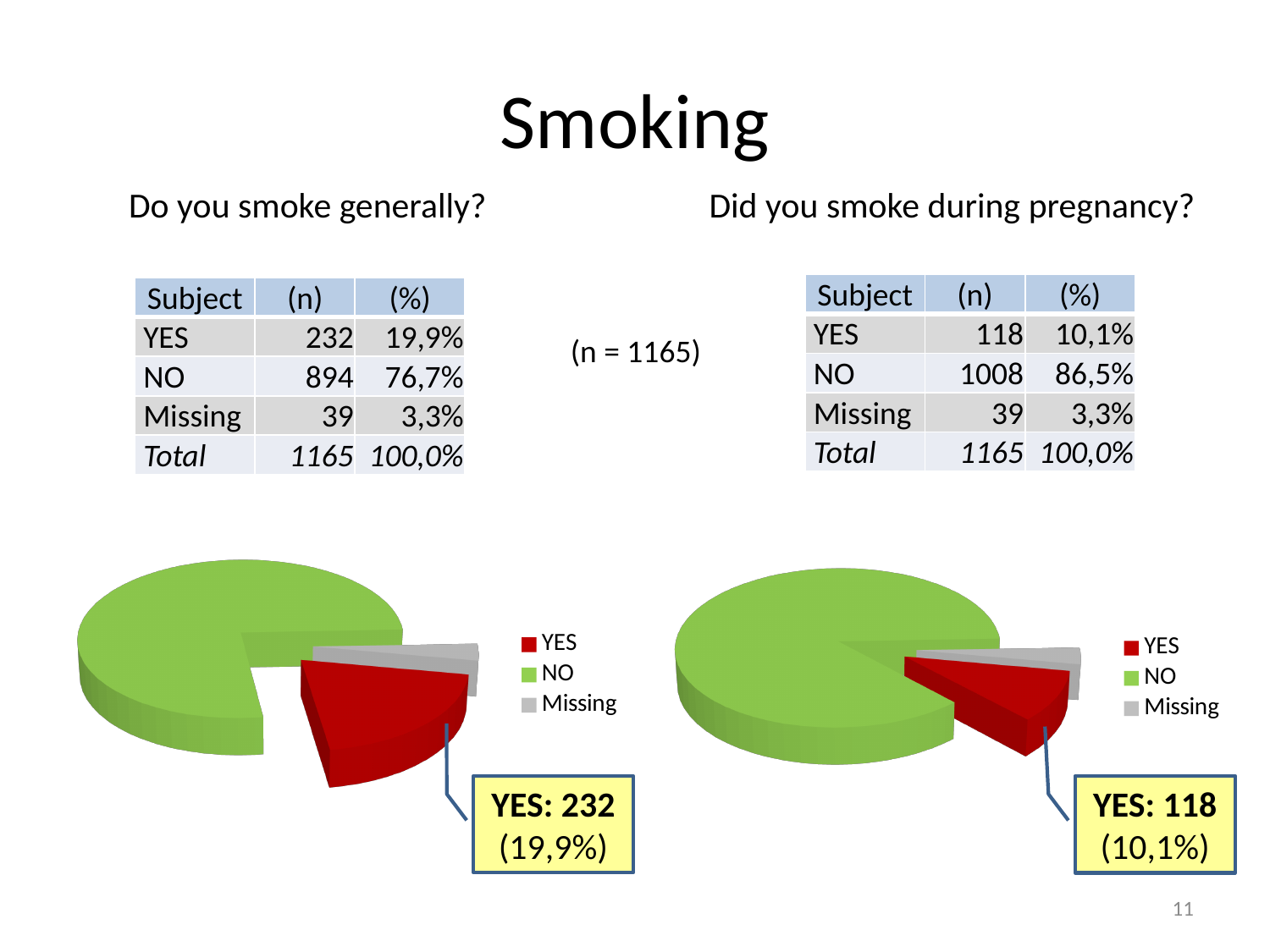
What is the difference between the YES count in the left pie chart (232) and the YES count in the right pie chart (118)? 114 What kind of chart is shown on the left side of the slide, under "Do you smoke generally?"? pie chart What colour is the NO slice in both pie charts? green In the right pie chart ("Did you smoke during pregnancy?"), what value is shown in the callout for the YES slice? 118 (10,1%) In the left pie chart ("Do you smoke generally?"), what value is shown in the callout for the YES slice? 232 (19,9%) In the left pie chart ("Do you smoke generally?"), what share of the pie does the Missing slice represent, according to the table? 3,3% In the right pie chart ("Did you smoke during pregnancy?"), which category has the smallest slice? Missing How many series does the legend of the left pie chart ("Do you smoke generally?") list? 3 In the left pie chart ("Do you smoke generally?"), which category has the largest slice? NO Comparing the YES slices, is the YES value larger in the left pie chart ("Do you smoke generally?") or the right pie chart ("Did you smoke during pregnancy?")? left (Do you smoke generally?) How many slices does the right pie chart ("Did you smoke during pregnancy?") have? 3 In the right pie chart ("Did you smoke during pregnancy?"), what share of the pie does the NO slice represent, according to the table? 86,5%